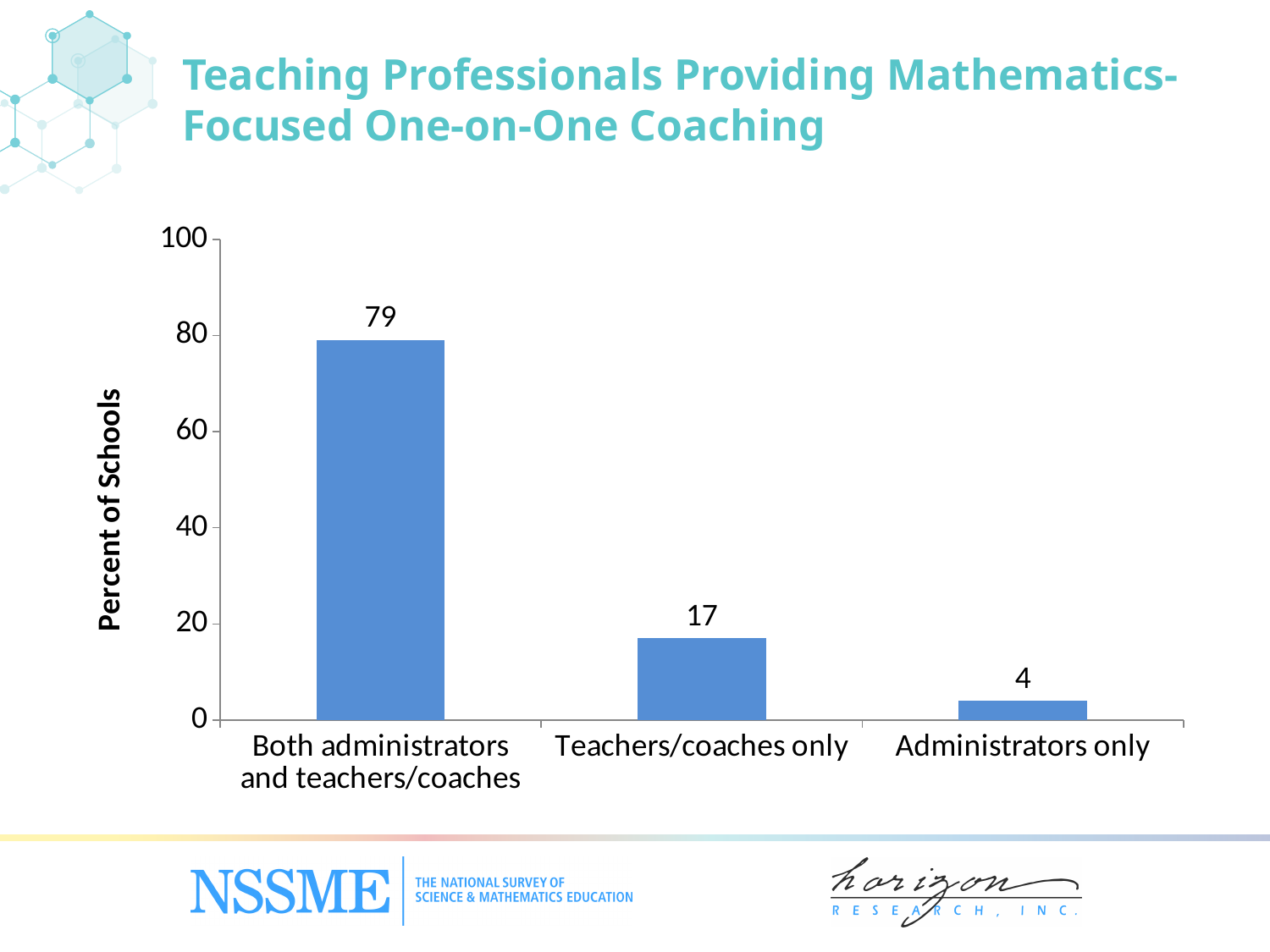
What is the difference between the values for Both administrators and teachers/coaches and Teachers/coaches only? 62 Which category has the highest percent of schools? Both administrators and teachers/coaches What is the value for Teachers/coaches only? 17 What percent of schools have both administrators and teachers/coaches providing mathematics-focused one-on-one coaching? 79 Is the value for Both administrators and teachers/coaches greater or less than 60? greater What is the difference between the values for Teachers/coaches only and Administrators only? 13 What is the value for Administrators only? 4 What kind of chart is shown on the slide? Bar chart Which is larger, the value for Teachers/coaches only or Administrators only? Teachers/coaches only What is the label of the y axis? Percent of Schools Which category has the lowest percent of schools? Administrators only How many categories are shown on the x axis? 3